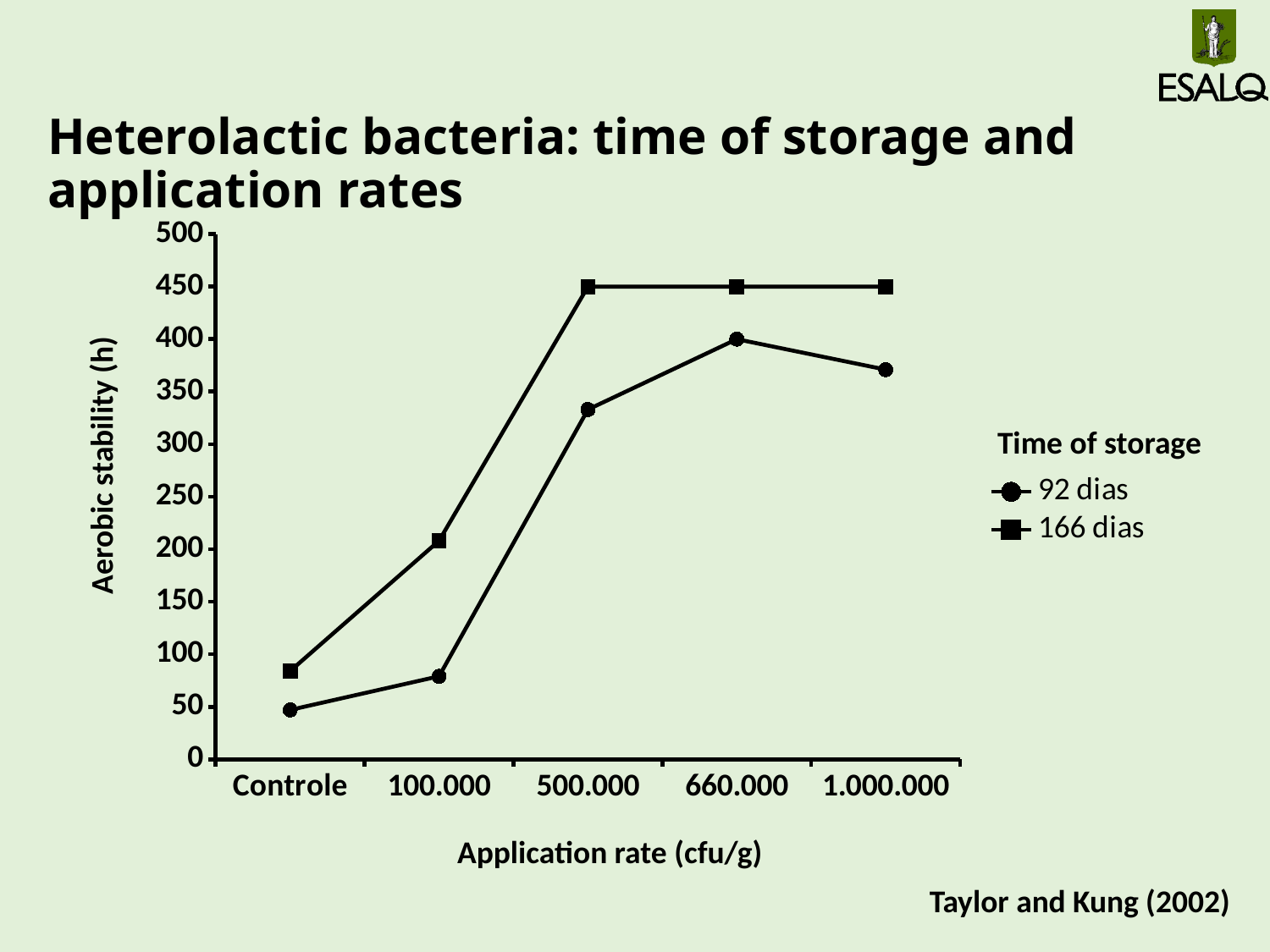
What kind of chart is shown on the slide? line chart At which application rate is the 92 dias series lowest? Controle How many application rate categories are shown on the x axis? 5 How many series does the legend list? 2 Is the value for 92 dias at 1.000.000 greater or less than 400? less Is the value for 166 dias at 100.000 greater or less than 150? greater Is the value for 166 dias at 500.000 greater or less than 400? greater At which application rate is the 166 dias series lowest? Controle At which application rate is the 92 dias series highest? 660.000 At 500.000 cfu/g, which series has the larger aerobic stability, 92 dias or 166 dias? 166 dias Does the 166 dias series rise or fall from Controle to 500.000? rise